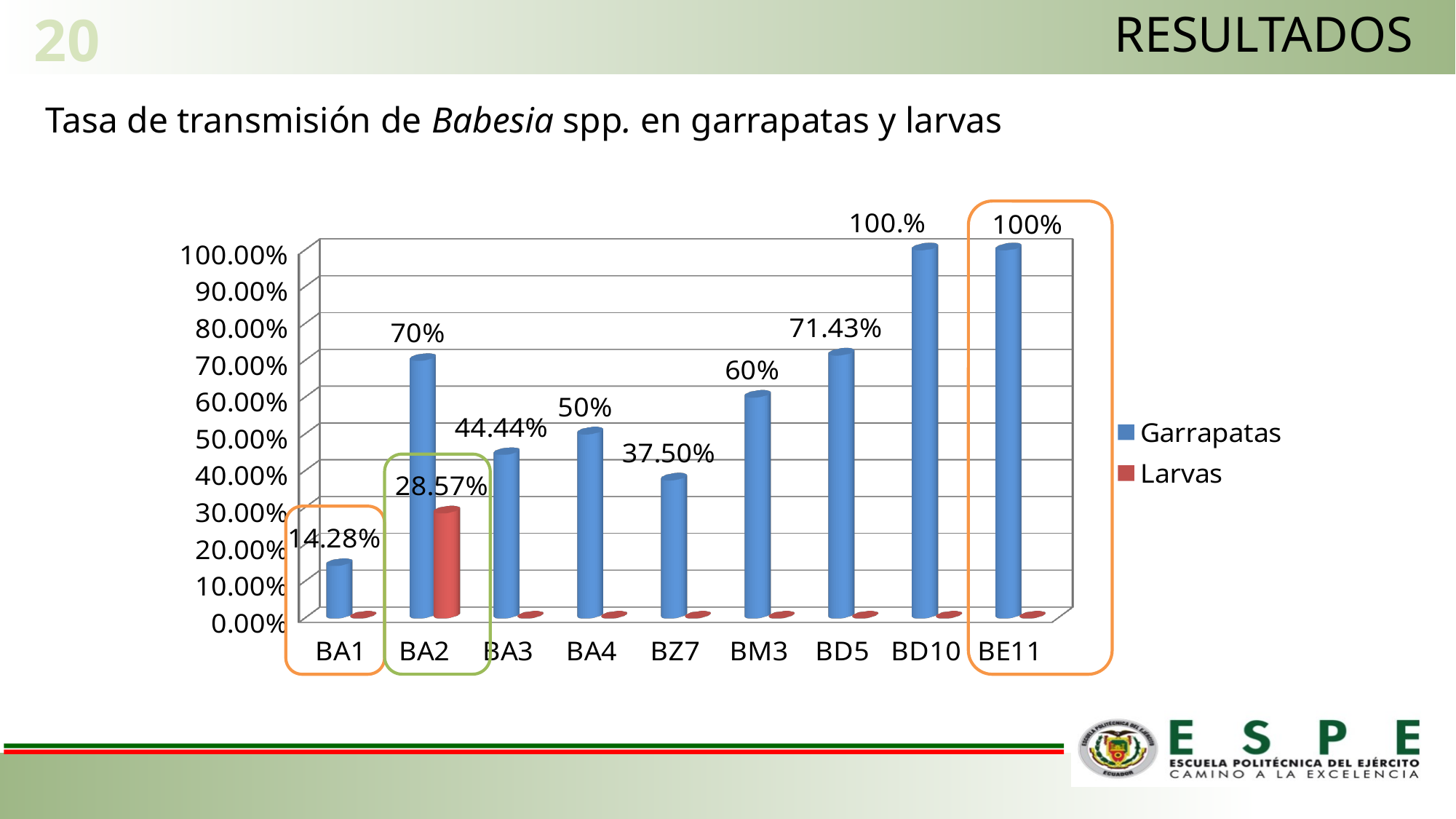
What is the Garrapatas value for BD5? 71.43% What kind of chart is shown on the slide? bar chart How many categories are shown on the x axis? 9 Is the Garrapatas value for BA3 greater or less than 40.00%? greater What is the Garrapatas value for BA2? 70% What is the Garrapatas value for BZ7? 37.50% Which has a larger Garrapatas value, BM3 or BA4? BM3 Which category has the lowest Garrapatas value? BA1 What is the Larvas value for BA2? 28.57% What is the difference between the Garrapatas values for BA2 and BA3? 25.56% Which series is shown in red in the legend? Larvas How many series does the legend list? 2